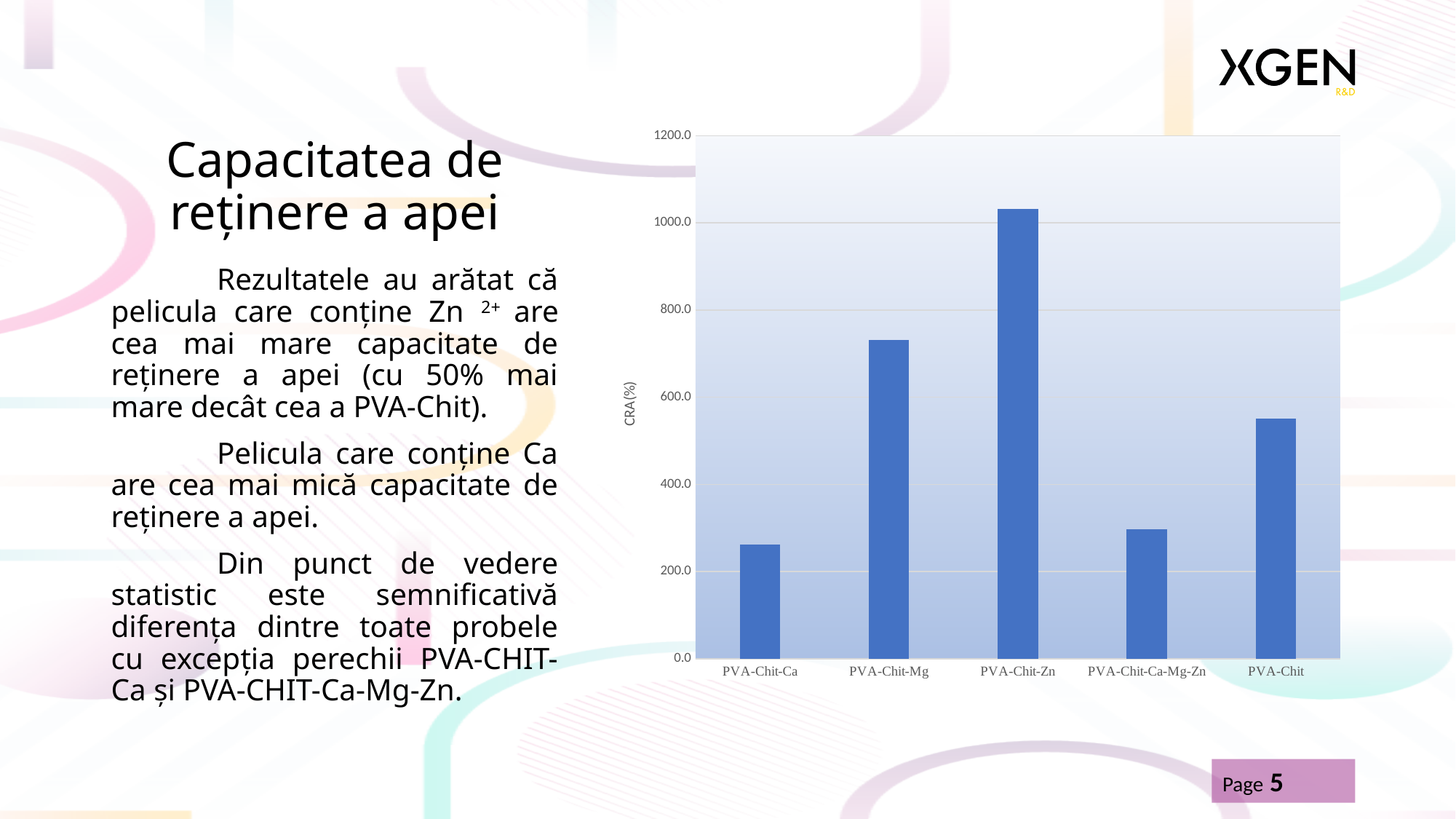
Is the value for PVA-Chit-Ca greater or less than 200.0? greater How many categories are plotted on the x axis of the chart? 5 Which has a larger CRA(%) value, PVA-Chit-Zn or PVA-Chit-Ca-Mg-Zn? PVA-Chit-Zn Which category has the lowest CRA(%) value in the chart? PVA-Chit-Ca Is the value for PVA-Chit-Zn greater or less than 800.0? greater What kind of chart is shown on the slide? bar chart Which has a larger CRA(%) value, PVA-Chit-Mg or PVA-Chit? PVA-Chit-Mg Which category has the highest CRA(%) value in the chart? PVA-Chit-Zn Is the value for PVA-Chit-Ca-Mg-Zn greater or less than 400.0? less What is the label of the y axis of the chart? CRA(%)